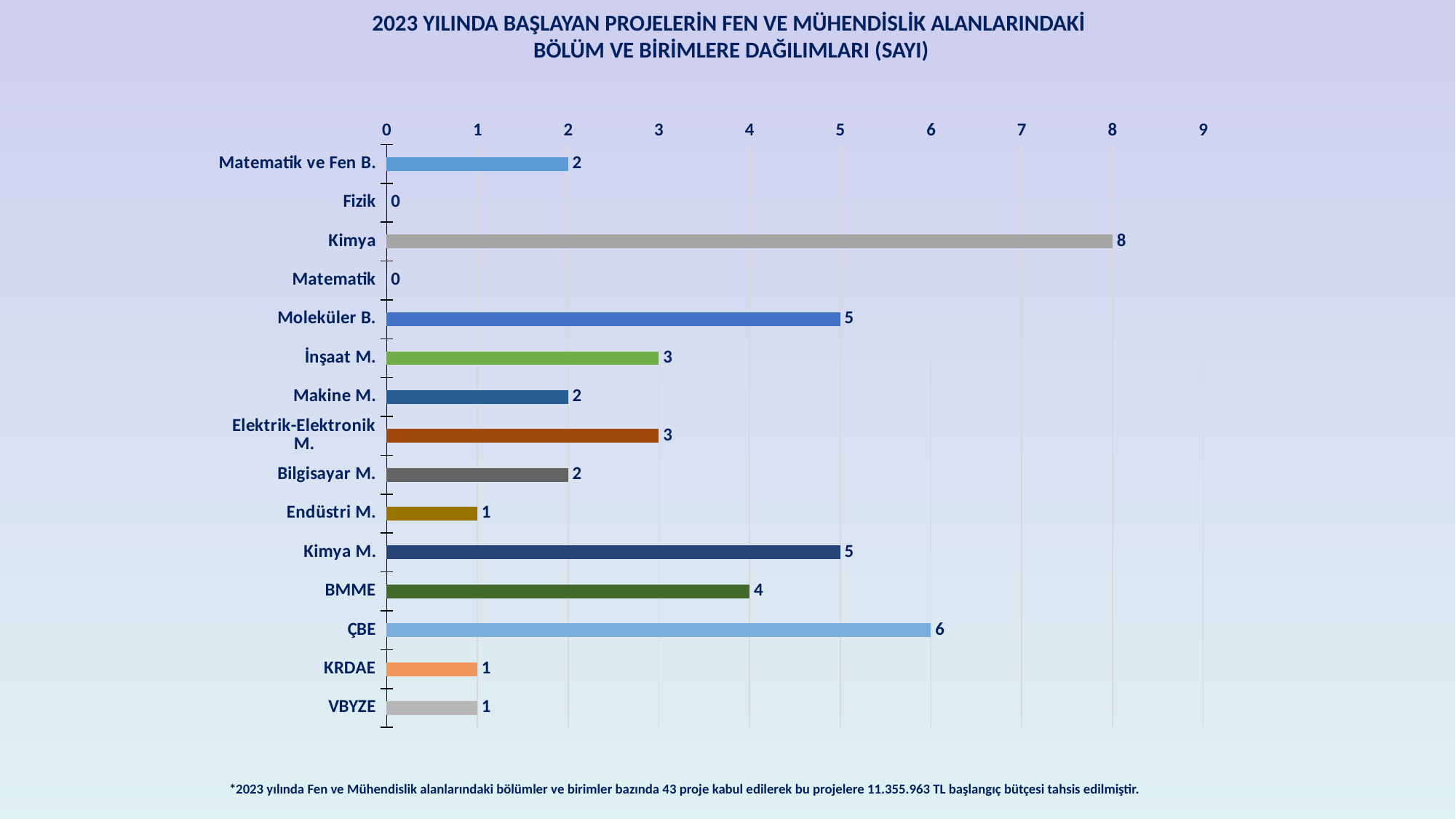
What is the difference between the values for Kimya and ÇBE? 2 What is the difference between the values for Moleküler B. and Endüstri M.? 4 Which is larger, the value for Kimya M. or the value for Makine M.? Kimya M. How many categories are shown on the chart? 15 What is the value for BMME? 4 What kind of chart is shown on the slide? Bar chart What is the value for Elektrik-Elektronik M.? 3 How many categories have a value of 0? 2 Which is larger, the value for BMME or the value for İnşaat M.? BMME What is the value for Kimya? 8 What is the value for ÇBE? 6 Which category has the highest value? Kimya